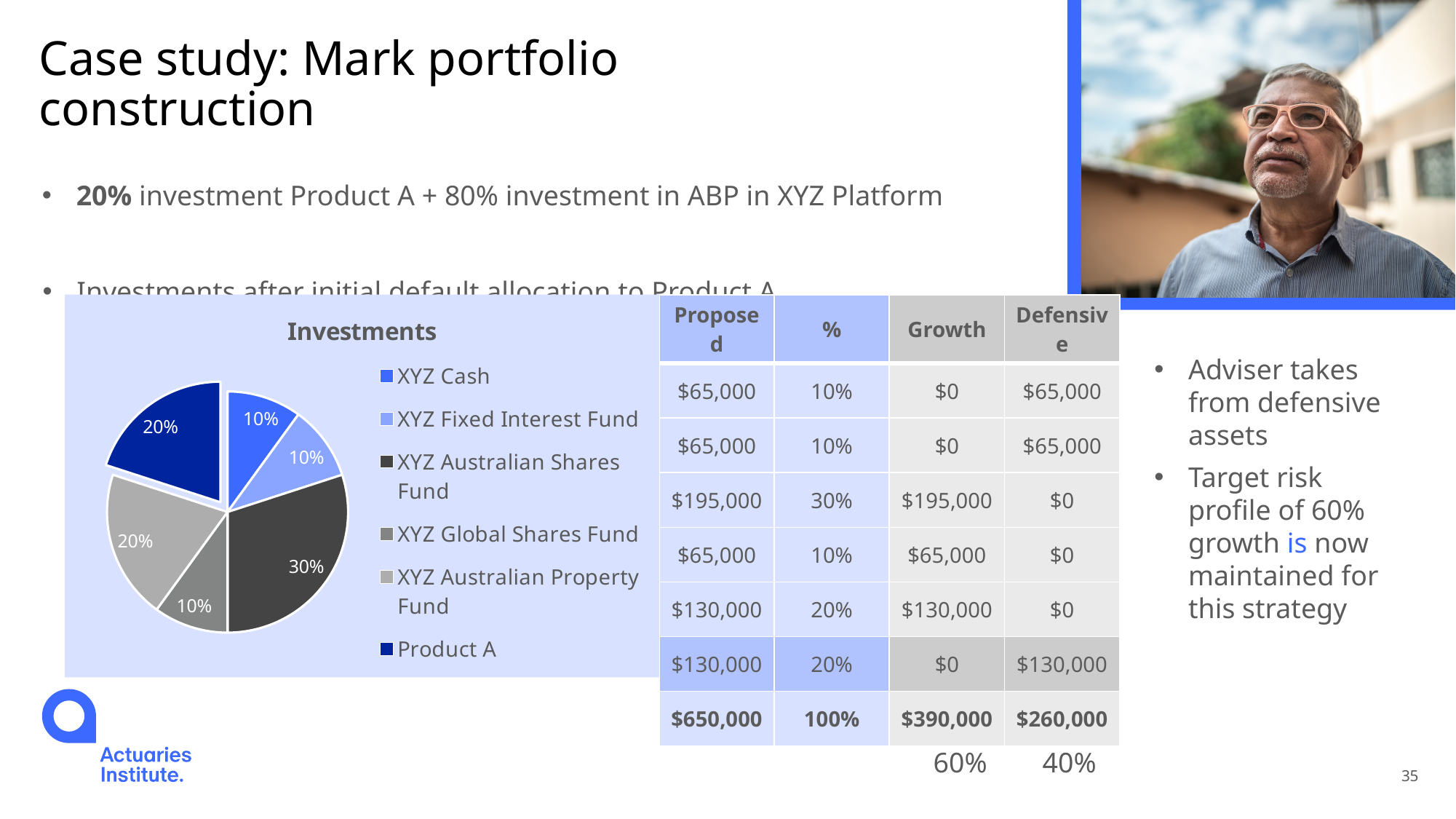
What share of the pie is XYZ Australian Shares Fund? 30% How many slices does the pie chart have? 6 Which category has the largest slice of the pie? XYZ Australian Shares Fund What is the value shown for XYZ Cash in the pie chart? 10% What share of the pie is Product A? 20% What is the difference between the XYZ Australian Shares Fund slice and the XYZ Global Shares Fund slice? 20% How many entries does the chart legend list? 6 What is the value shown for XYZ Australian Property Fund in the pie chart? 20% Which is larger, the Product A slice or the XYZ Fixed Interest Fund slice? Product A What is the title of the chart? Investments What type of chart is shown on the slide? pie chart Which slice of the pie is pulled out (exploded) from the rest? Product A